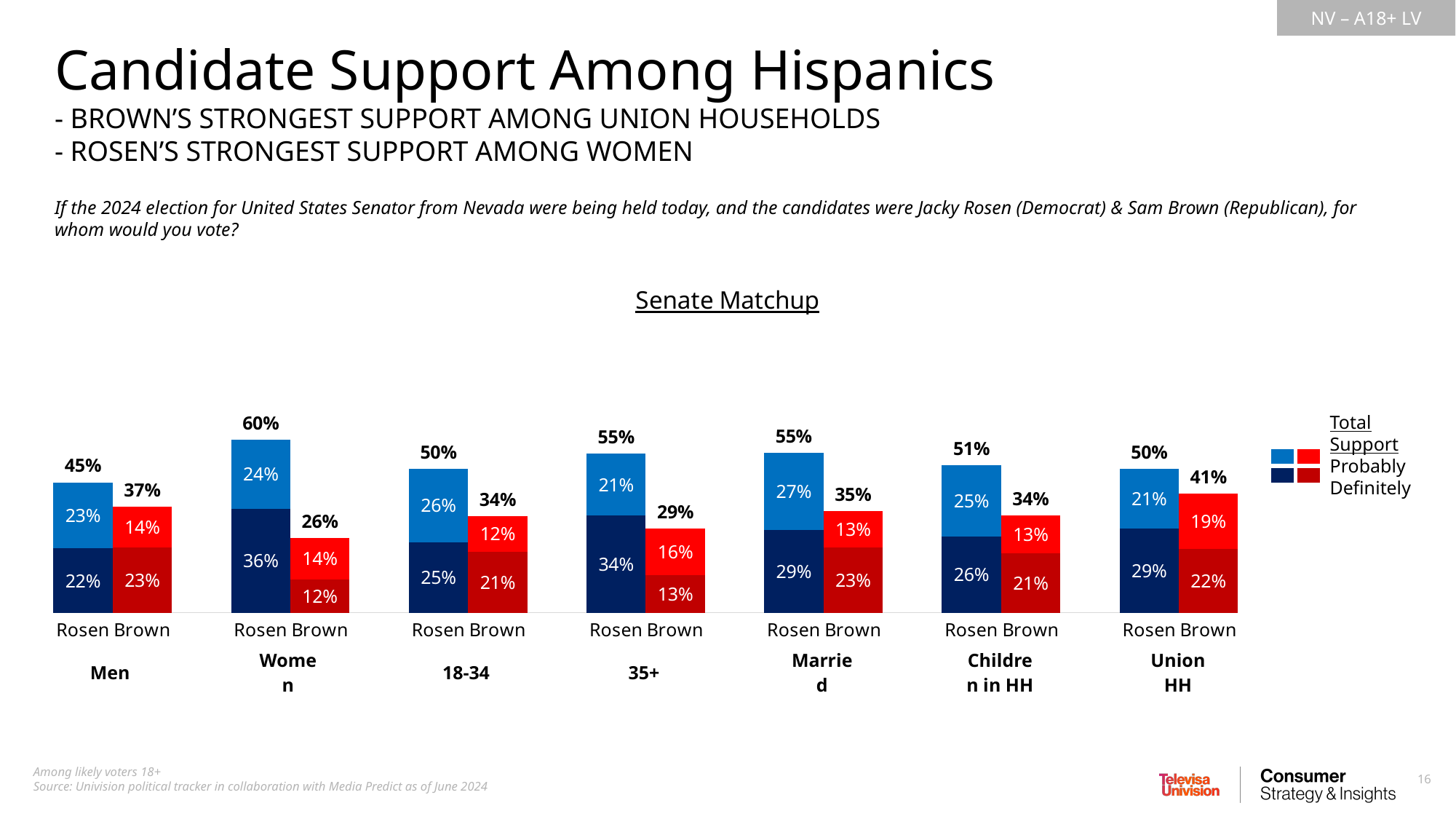
What is Rosen's total support among Women? 60% Among 18-34 voters, who has higher total support, Rosen or Brown? Rosen What kind of chart is shown on the slide? Stacked bar chart What is Rosen's 'Probably' support among Married voters? 27% How many demographic groups are shown on the x axis? 7 What is Brown's 'Definitely' support among Men? 23% In which demographic group is Rosen's total support highest? Women What is the difference between Rosen's and Brown's total support among 35+ voters? 26 percentage points In which demographic group is Brown's total support lowest? Women What is the title of the chart? Senate Matchup What is Brown's total support among Union HH? 41% What is the total of Rosen's stacked bar among Children in HH? 51%